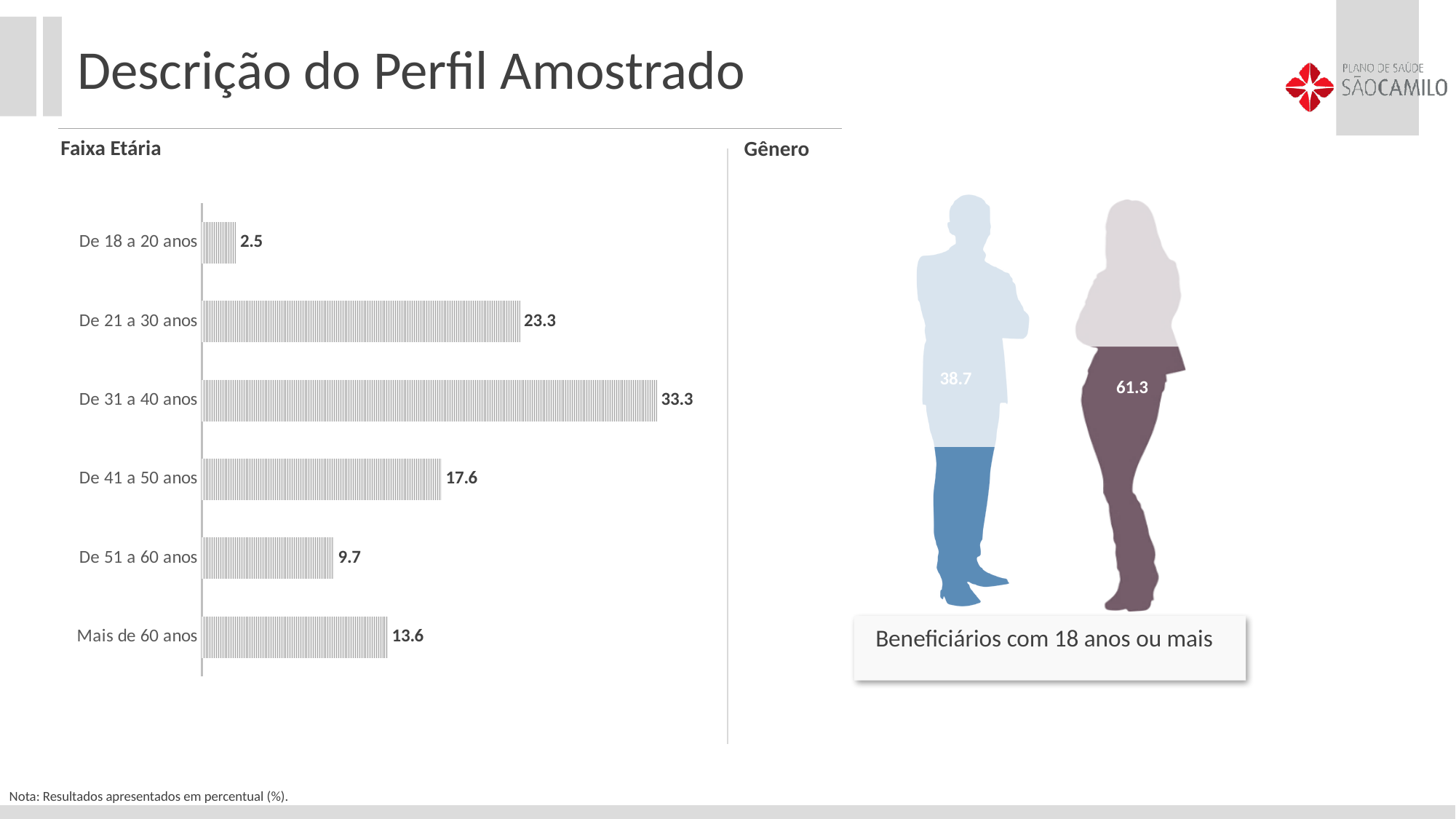
In the Gênero graphic, what is the value shown on the female figure? 61.3 In the Faixa Etária chart, what is the value for Mais de 60 anos? 13.6 What kind of chart is the Faixa Etária chart? Bar chart In the Faixa Etária chart, which age group has the lowest value? De 18 a 20 anos In the Faixa Etária chart, what is the value for De 51 a 60 anos? 9.7 In the Faixa Etária chart, what is the difference between the values for De 41 a 50 anos and De 51 a 60 anos? 7.9 In the Faixa Etária chart, which is larger: the value for De 41 a 50 anos or Mais de 60 anos? De 41 a 50 anos In the Faixa Etária chart, what is the difference between the values for De 31 a 40 anos and De 21 a 30 anos? 10.0 In the Gênero graphic, what is the difference between the female and male values? 22.6 In the Faixa Etária chart, which age group has the highest value? De 31 a 40 anos How many age groups are shown in the Faixa Etária chart? 6 In the Faixa Etária chart, what is the value for De 31 a 40 anos? 33.3